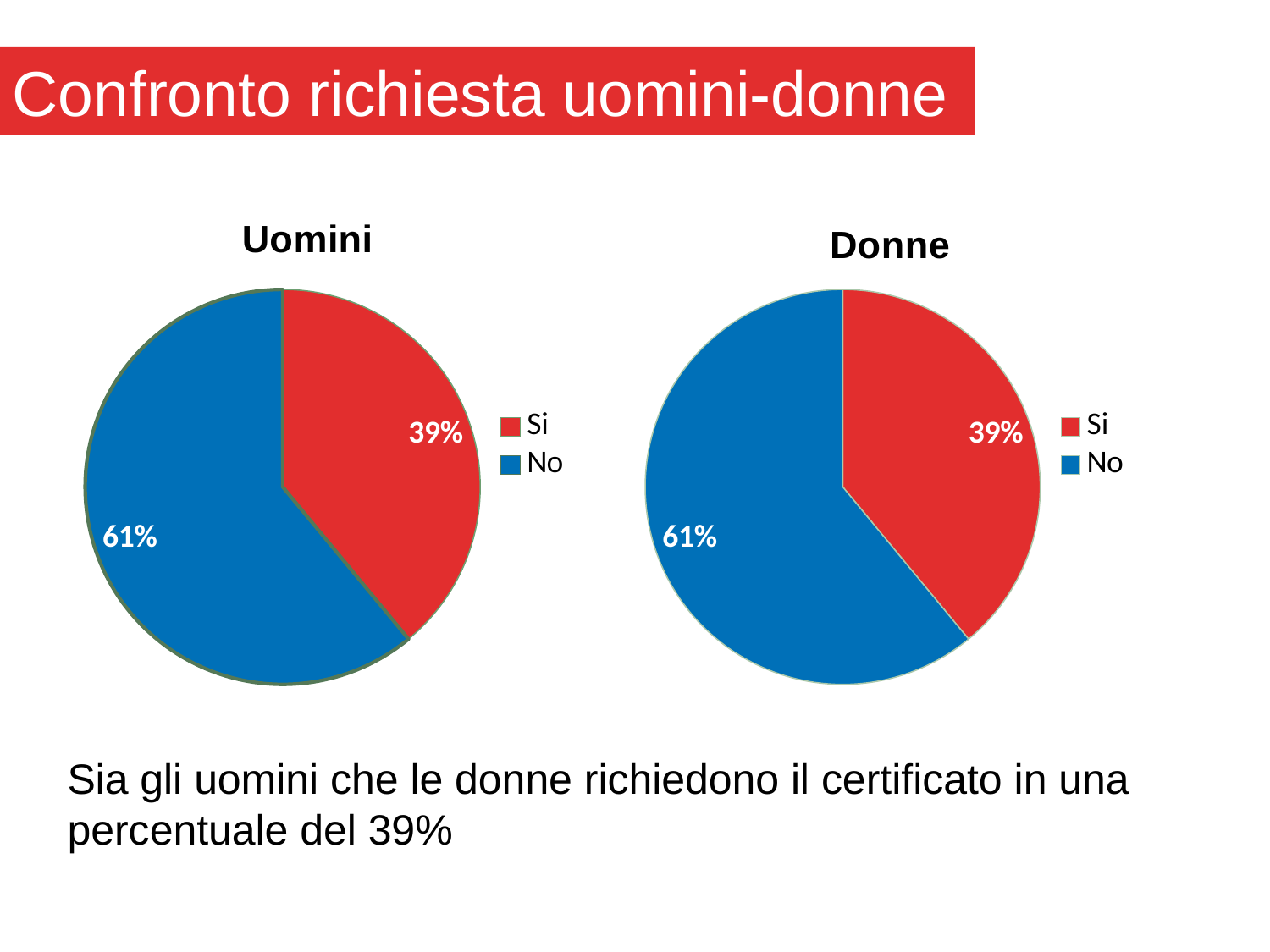
In the "Donne" pie chart, what percentage is shown for "No"? 61% In the "Donne" pie chart, which slice is the smallest? Si In the "Uomini" pie chart, what percentage is shown for "No"? 61% How many slices does the "Donne" pie chart have? 2 In the "Donne" pie chart, what colour is the "No" slice? Blue In the "Donne" pie chart, which is larger, "Si" or "No"? No In the "Uomini" pie chart, what is the difference between the "No" and "Si" percentages? 22% What type of chart is the "Uomini" chart? Pie chart In the "Uomini" pie chart, which slice is the largest? No How many entries does the legend of the "Uomini" chart list? 2 In the "Uomini" pie chart, what percentage is shown for "Si"? 39% In the "Donne" pie chart, what percentage is shown for "Si"? 39%